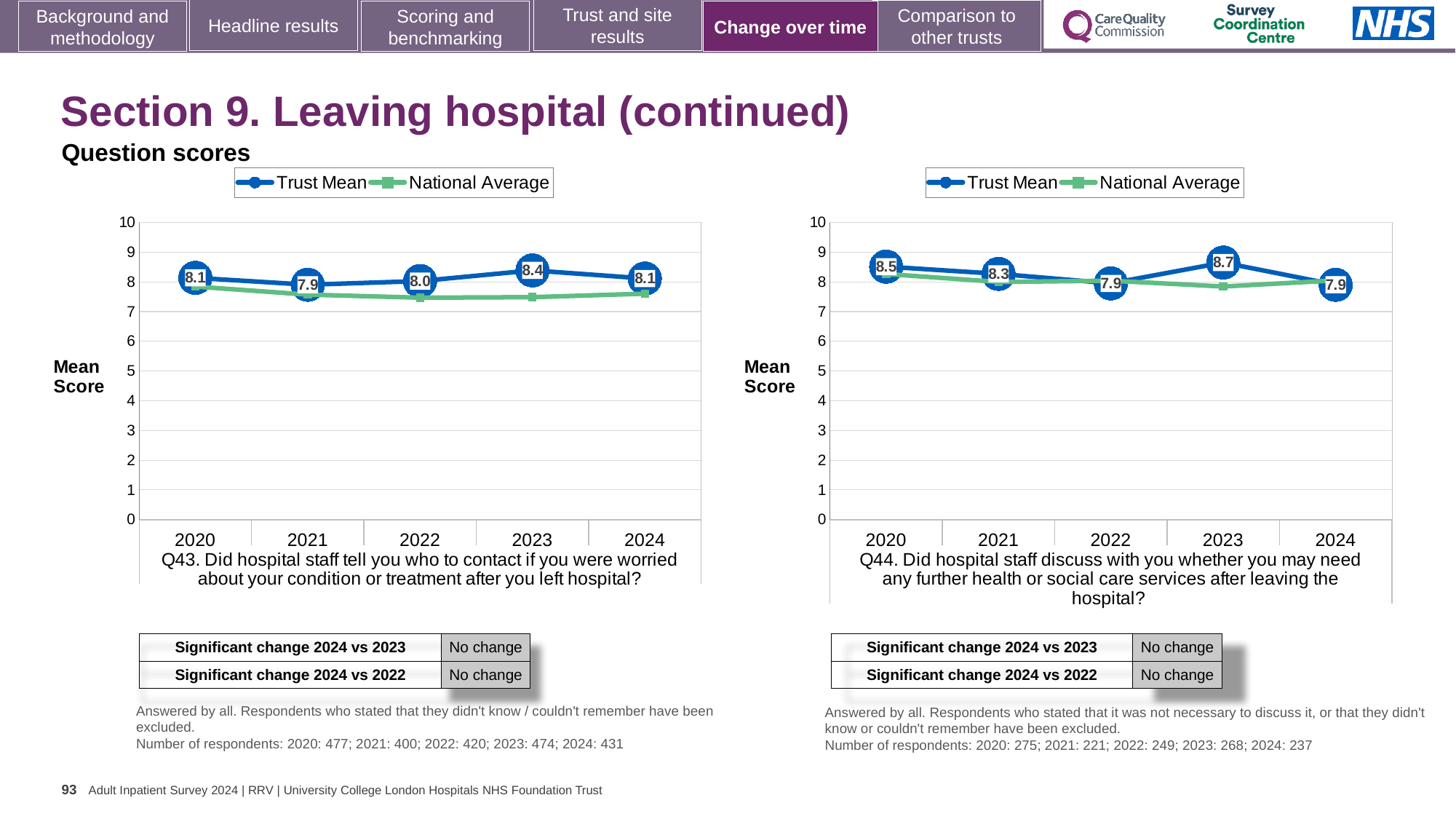
In the Q44 chart (right), what is the difference between the Trust Mean scores for 2023 and 2024? 0.8 In the Q44 chart (right), which year has the highest Trust Mean score? 2023 In the Q43 chart (left), is the Trust Mean score for 2023 larger or smaller than the Trust Mean score for 2022? larger How many years are plotted on the x axis of the Q44 chart (right)? 5 What type of chart is used for the Q44 chart (right)? Line chart In the Q43 chart (left), is the National Average value for 2022 greater or less than 8? less In the Q44 chart (right), what is the Trust Mean score for 2024? 7.9 In the Q43 chart (left), what is the Trust Mean score for 2023? 8.4 How many series does the legend of the Q43 chart (left) list? 2 In the Q43 chart (left), what is the Trust Mean score for 2021? 7.9 In the Q43 chart (left), which year has the lowest Trust Mean score? 2021 In the Q44 chart (right), what is the Trust Mean score for 2020? 8.5